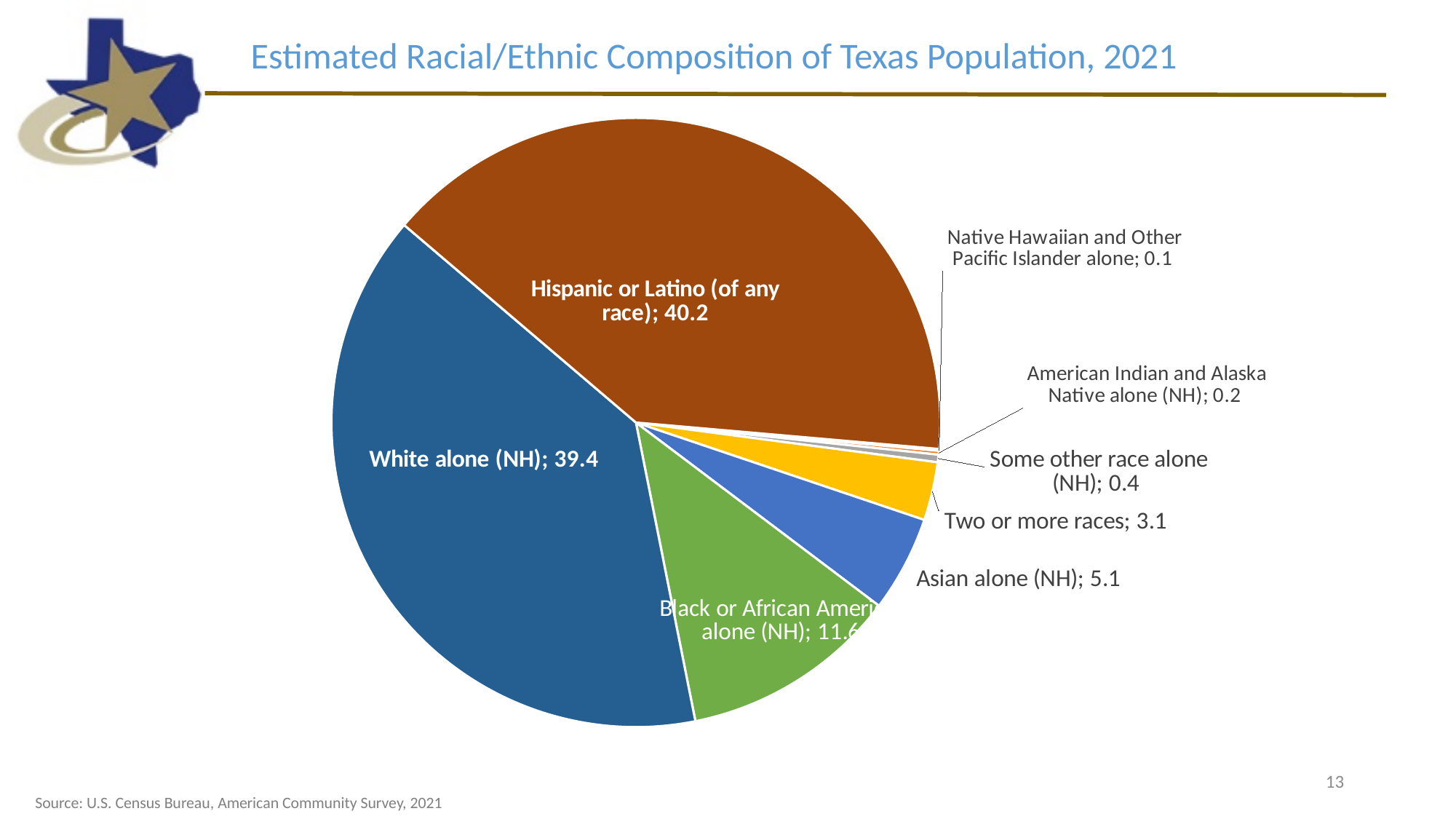
What is the value for Two or more races? 3.1 Which is larger, the value for Asian alone (NH) or the value for Two or more races? Asian alone (NH) What is the difference between the values for Hispanic or Latino (of any race) and White alone (NH)? 0.8 What is the value for Native Hawaiian and Other Pacific Islander alone? 0.1 How many slices does the pie chart have? 8 Which category has the largest slice of the pie? Hispanic or Latino (of any race) Which category has the smallest slice of the pie? Native Hawaiian and Other Pacific Islander alone What is the value for Hispanic or Latino (of any race)? 40.2 What kind of chart is shown on the slide? pie chart What is the value for White alone (NH)? 39.4 What is the value for Asian alone (NH)? 5.1 What is the value for Some other race alone (NH)? 0.4